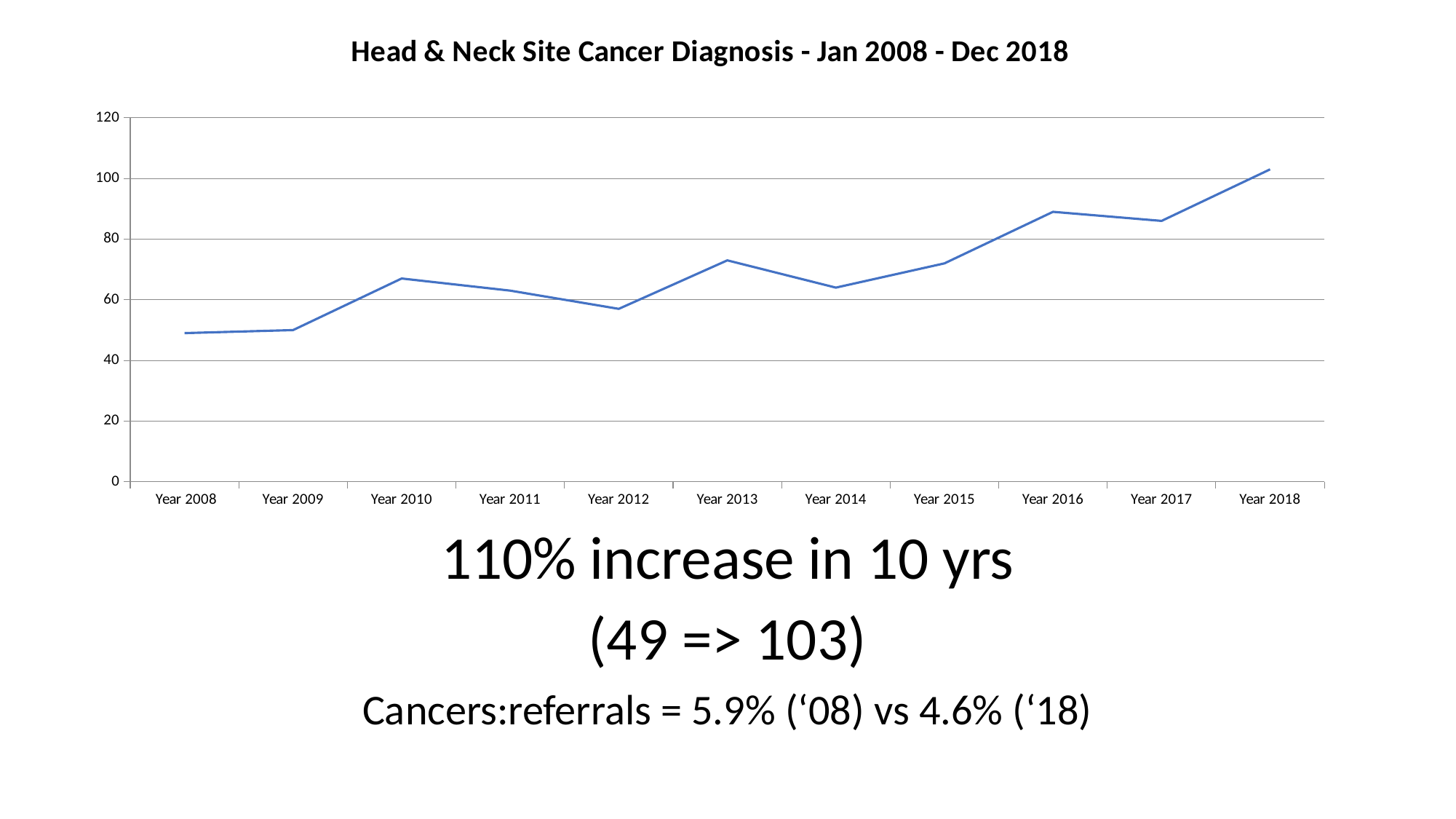
How many years are plotted on the x axis of the chart? 11 What is the title of the chart? Head & Neck Site Cancer Diagnosis - Jan 2008 - Dec 2018 What kind of chart is shown on the slide? line chart What is the value for Year 2018? 103 Which is larger, the value for Year 2013 or the value for Year 2014? Year 2013 Is the value for Year 2014 greater or less than 80? less What is the difference between the value for Year 2018 and the value for Year 2008? 54 Is the value for Year 2016 greater or less than 80? greater Do the values generally rise or fall from Year 2008 to Year 2018? rise What is the value for Year 2008? 49 Which year has the highest value on the chart? Year 2018 Is the value for Year 2010 greater or less than 60? greater